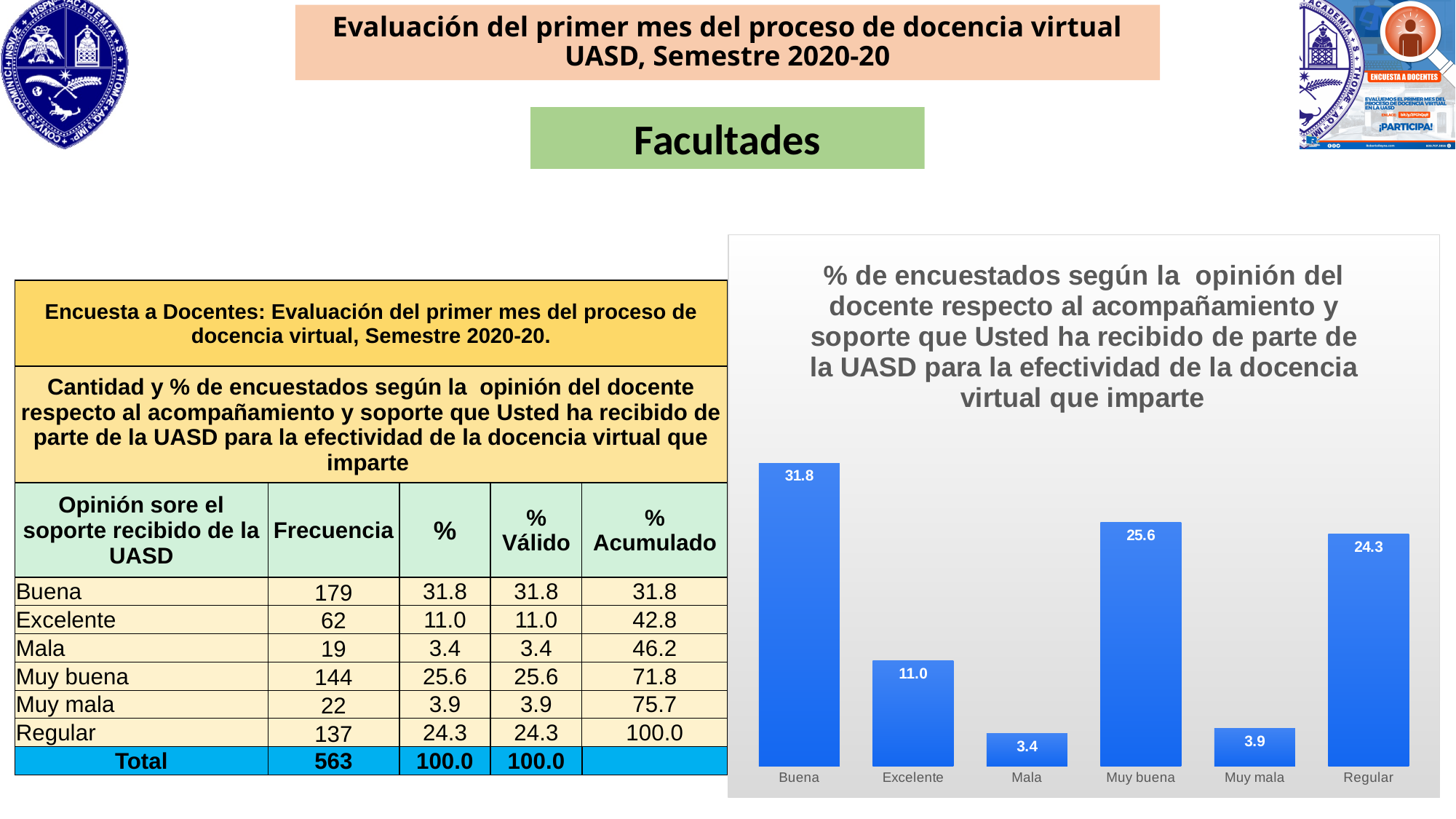
Which category has the highest value in the bar chart? Buena Which is larger in the bar chart, the value for Muy buena or the value for Regular? Muy buena What kind of chart is shown on the slide? Bar chart What is the value for Regular in the bar chart? 24.3 How many categories are shown in the bar chart? 6 What colour are the bars in the chart? Blue What is the difference between the values for Buena and Muy buena in the bar chart? 6.2 Which category has the lowest value in the bar chart? Mala What is the value for Excelente in the bar chart? 11.0 What is the value for Muy buena in the bar chart? 25.6 What is the value for Buena in the bar chart? 31.8 What is the difference between the values for Muy mala and Mala in the bar chart? 0.5